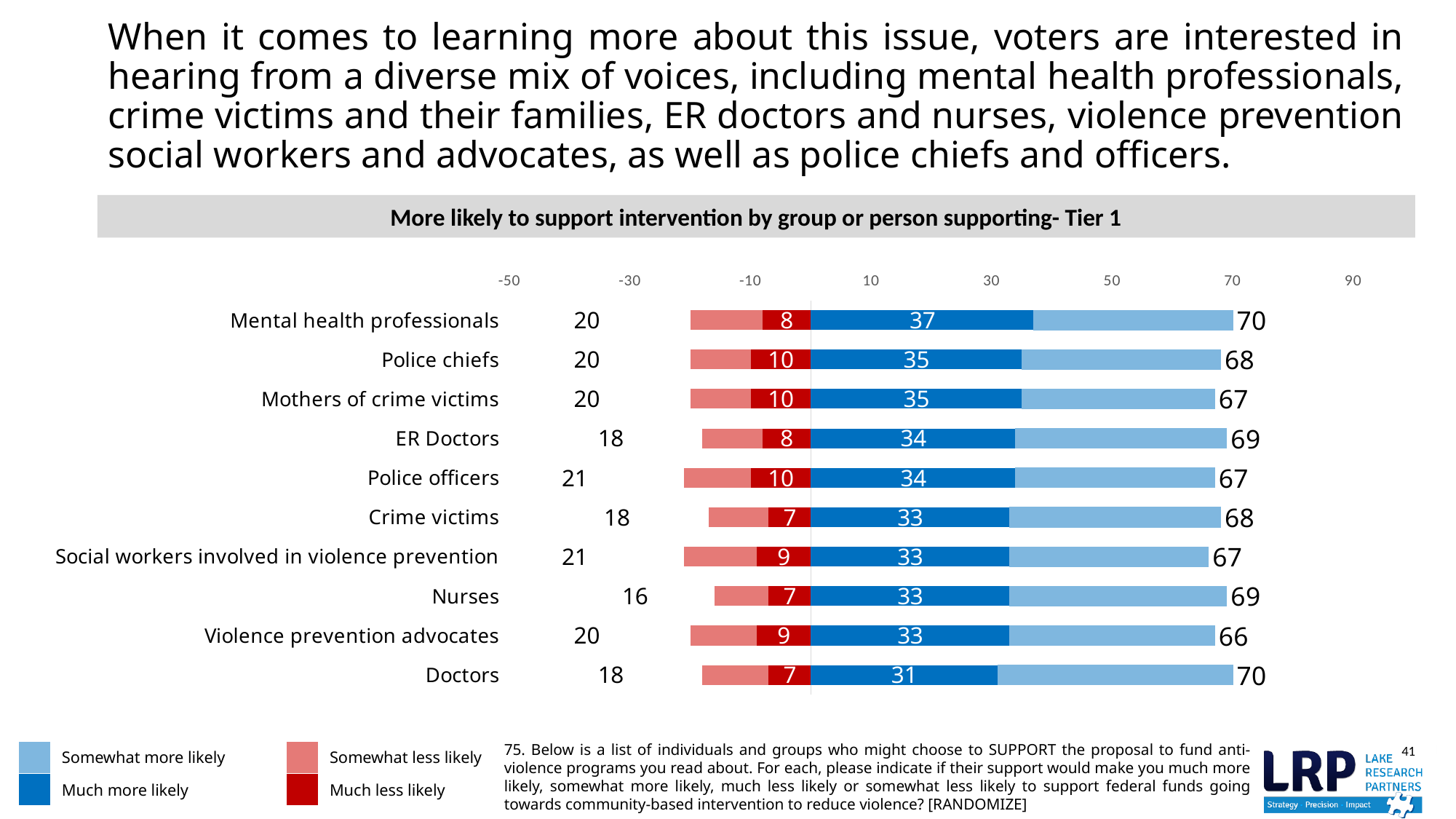
What is the 'Much more likely' value for Mental health professionals? 37 Which group has the lowest total 'less likely' value shown at the left of its bar? Nurses What is the total 'more likely' value shown at the right end of the bar for Doctors? 70 Which group has the lowest total 'more likely' value shown at the right end of its bar? Violence prevention advocates What is the difference between the 'Much more likely' values for Mental health professionals and Doctors? 6 How many series does the legend list? 4 What is the 'Much less likely' value for Police chiefs? 10 Which group has the lowest 'Much more likely' value? Doctors Which has a larger 'Much more likely' value, Police chiefs or Nurses? Police chiefs How many groups are shown in the chart? 10 What type of chart is shown on the slide? Stacked bar chart Which group has the highest 'Much more likely' value? Mental health professionals